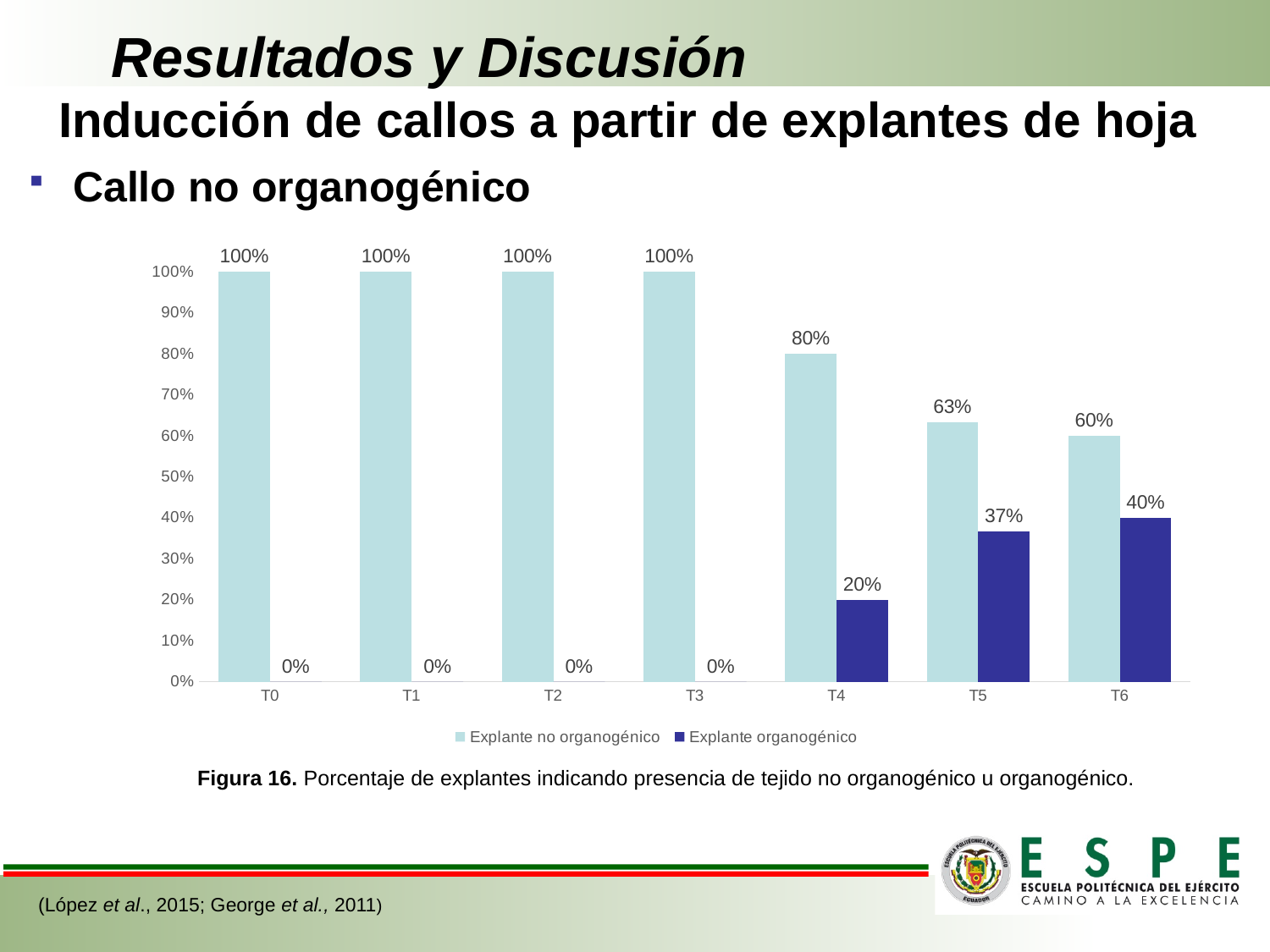
What is the value for Explante no organogénico at T4? 80% What is the value for Explante organogénico at T6? 40% What is the difference between Explante no organogénico and Explante organogénico at T4? 60% What is the value for Explante no organogénico at T5? 63% What is the value for Explante organogénico at T5? 37% Which is larger at T5: Explante no organogénico or Explante organogénico? Explante no organogénico Which category has the lowest value for Explante no organogénico? T6 How many categories are shown on the x axis? 7 How many series does the legend list? 2 Does the value for Explante organogénico rise or fall from T3 to T6? Rise Which category has the highest value for Explante organogénico? T6 What kind of chart is shown on the slide? Bar chart